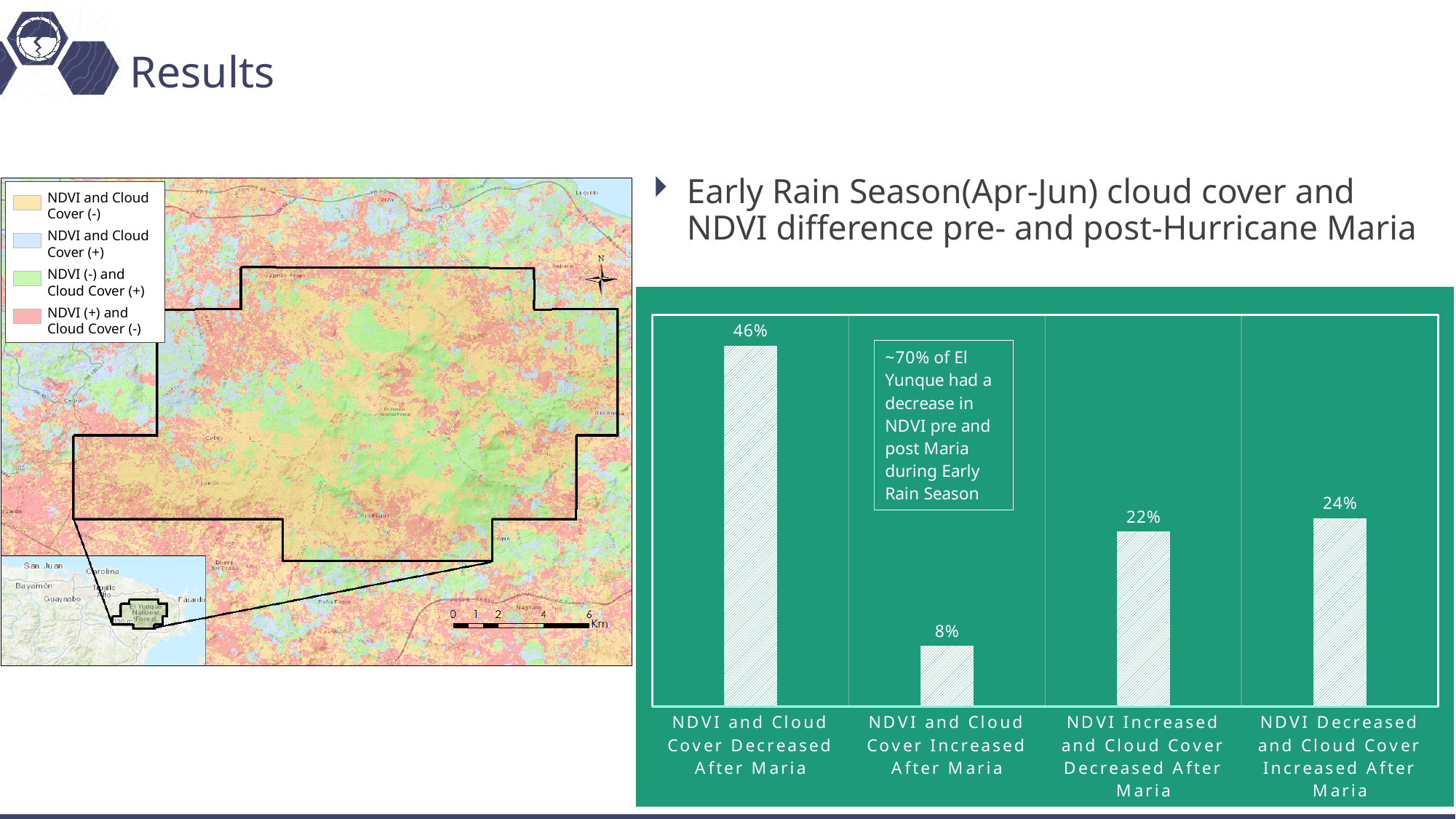
What is the value for 'NDVI and Cloud Cover Decreased After Maria'? 46% What is the value for 'NDVI and Cloud Cover Increased After Maria'? 8% What is the value for 'NDVI Increased and Cloud Cover Decreased After Maria'? 22% According to the text box inside the chart, approximately what share of El Yunque had a decrease in NDVI pre and post Maria during Early Rain Season? ~70% What is the difference between the values for 'NDVI Decreased and Cloud Cover Increased After Maria' and 'NDVI Increased and Cloud Cover Decreased After Maria'? 2% What is the value for 'NDVI Decreased and Cloud Cover Increased After Maria'? 24% What kind of chart is shown on the right side of the slide? Bar chart Which is larger: the value for 'NDVI Increased and Cloud Cover Decreased After Maria' or 'NDVI and Cloud Cover Increased After Maria'? NDVI Increased and Cloud Cover Decreased After Maria How many categories are shown in the bar chart? 4 Which category has the lowest value in the bar chart? NDVI and Cloud Cover Increased After Maria What is the difference between the values for 'NDVI and Cloud Cover Decreased After Maria' and 'NDVI and Cloud Cover Increased After Maria'? 38% Which category has the highest value in the bar chart? NDVI and Cloud Cover Decreased After Maria